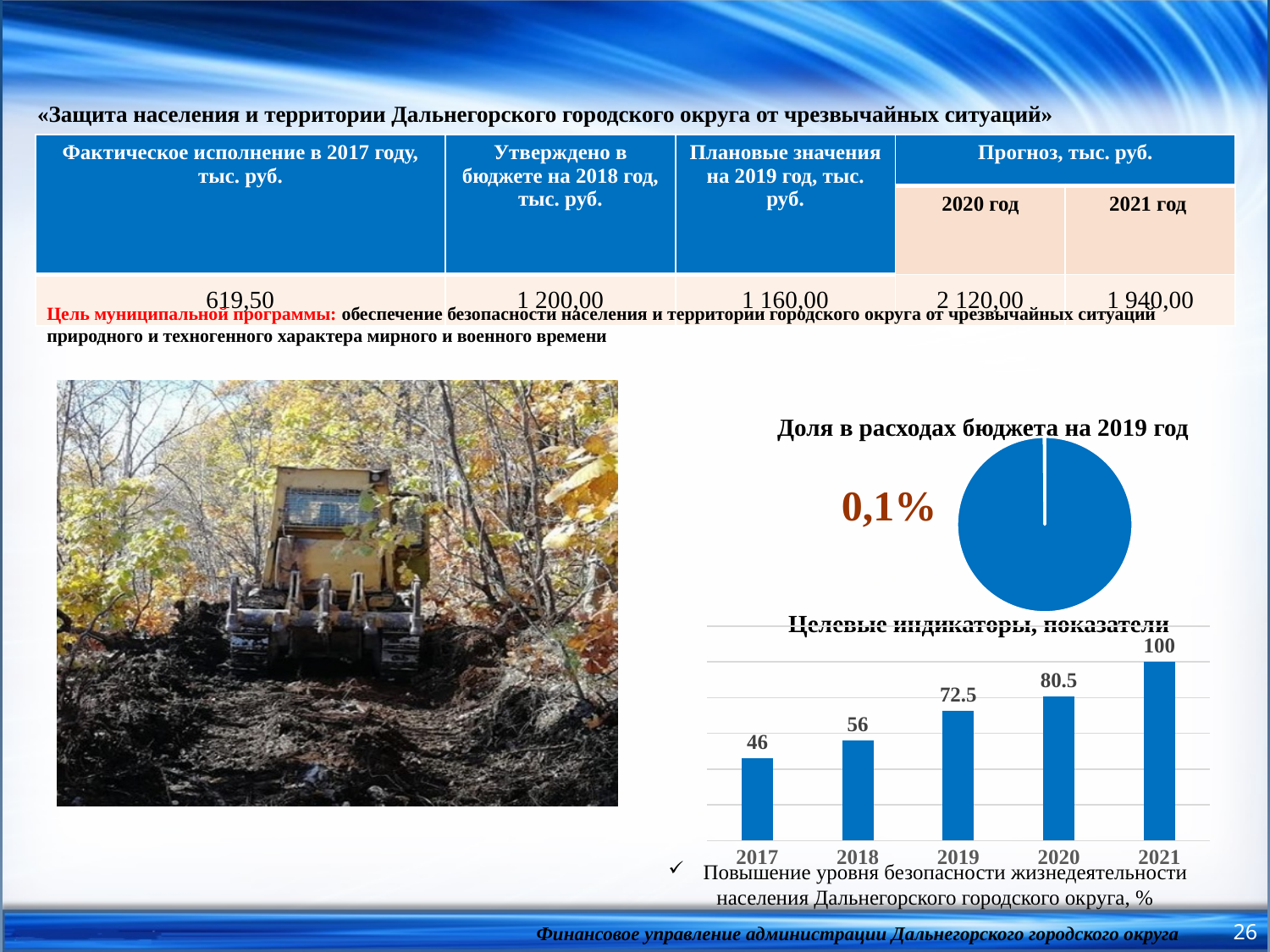
Do the values in the bar chart 'Целевые индикаторы, показатели' rise or fall from 2017 to 2021? rise How many years are shown in the bar chart 'Целевые индикаторы, показатели'? 5 What kind of chart is 'Целевые индикаторы, показатели'? bar chart In the bar chart 'Целевые индикаторы, показатели', what is the difference between the values for 2020 and 2018? 24.5 In the bar chart 'Целевые индикаторы, показатели', what is the value for 2019? 72.5 In the bar chart 'Целевые индикаторы, показатели', what is the value for 2017? 46 In the bar chart 'Целевые индикаторы, показатели', what is the value for 2021? 100 What share is shown in the pie chart 'Доля в расходах бюджета на 2019 год'? 0,1% What kind of chart is 'Доля в расходах бюджета на 2019 год'? pie chart In the bar chart 'Целевые индикаторы, показатели', which is larger: the value for 2019 or the value for 2018? 2019 In the bar chart 'Целевые индикаторы, показатели', which year has the lowest value? 2017 In the bar chart 'Целевые индикаторы, показатели', which year has the highest value? 2021